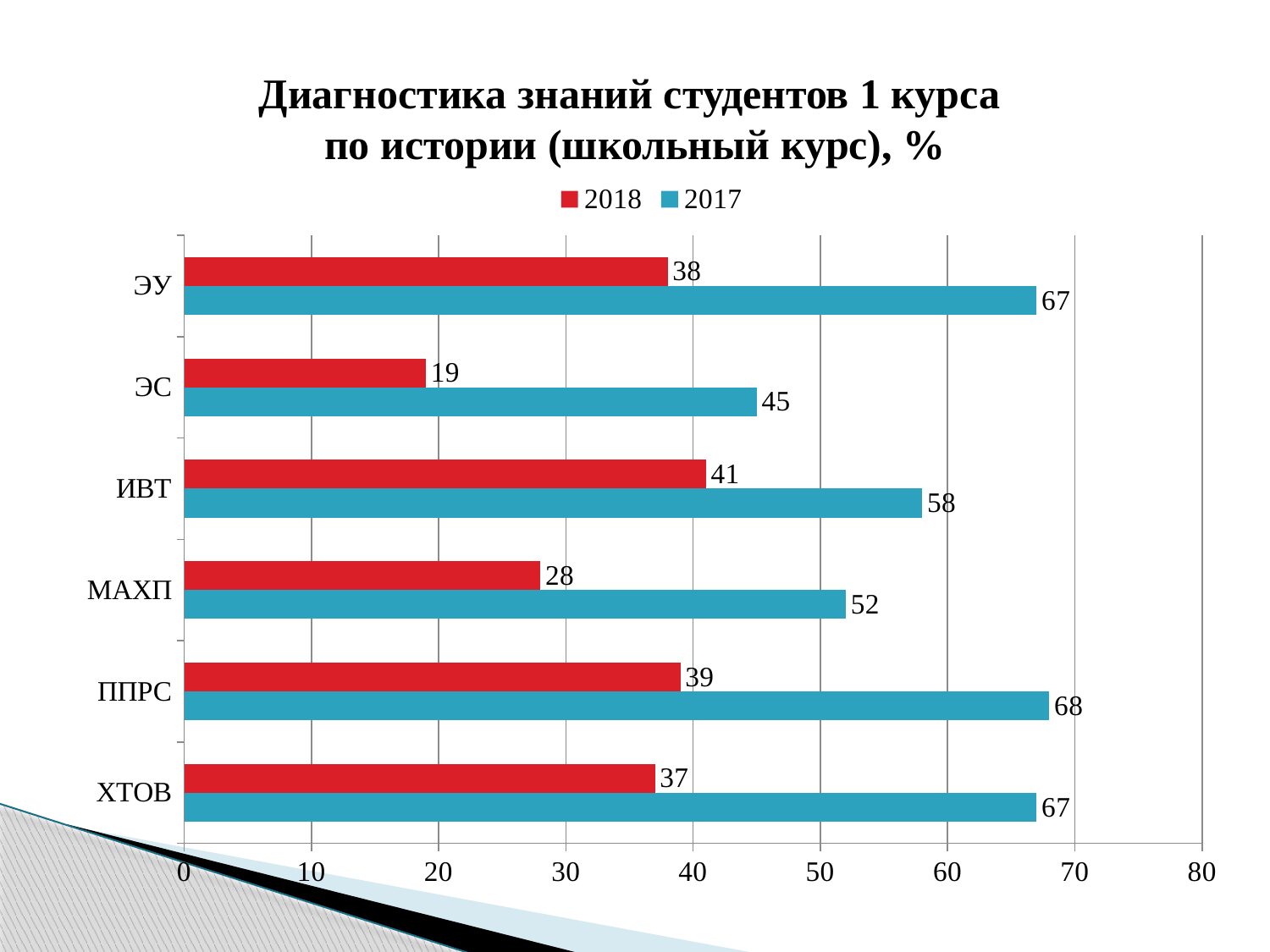
How many series does the legend list? 2 How many categories are shown on the chart? 6 What is the 2017 value for ЭС? 45 Which category has the lowest 2018 value? ЭС What is the 2018 value for ППРС? 39 What is the 2018 value for ЭУ? 38 What kind of chart is shown on the slide? bar chart Which is larger for ХТОВ: the 2017 value or the 2018 value? 2017 Which colour represents the 2018 series? red What is the 2017 value for МАХП? 52 Which category has the highest 2017 value? ППРС What is the difference between the 2017 and 2018 values for ИВТ? 17